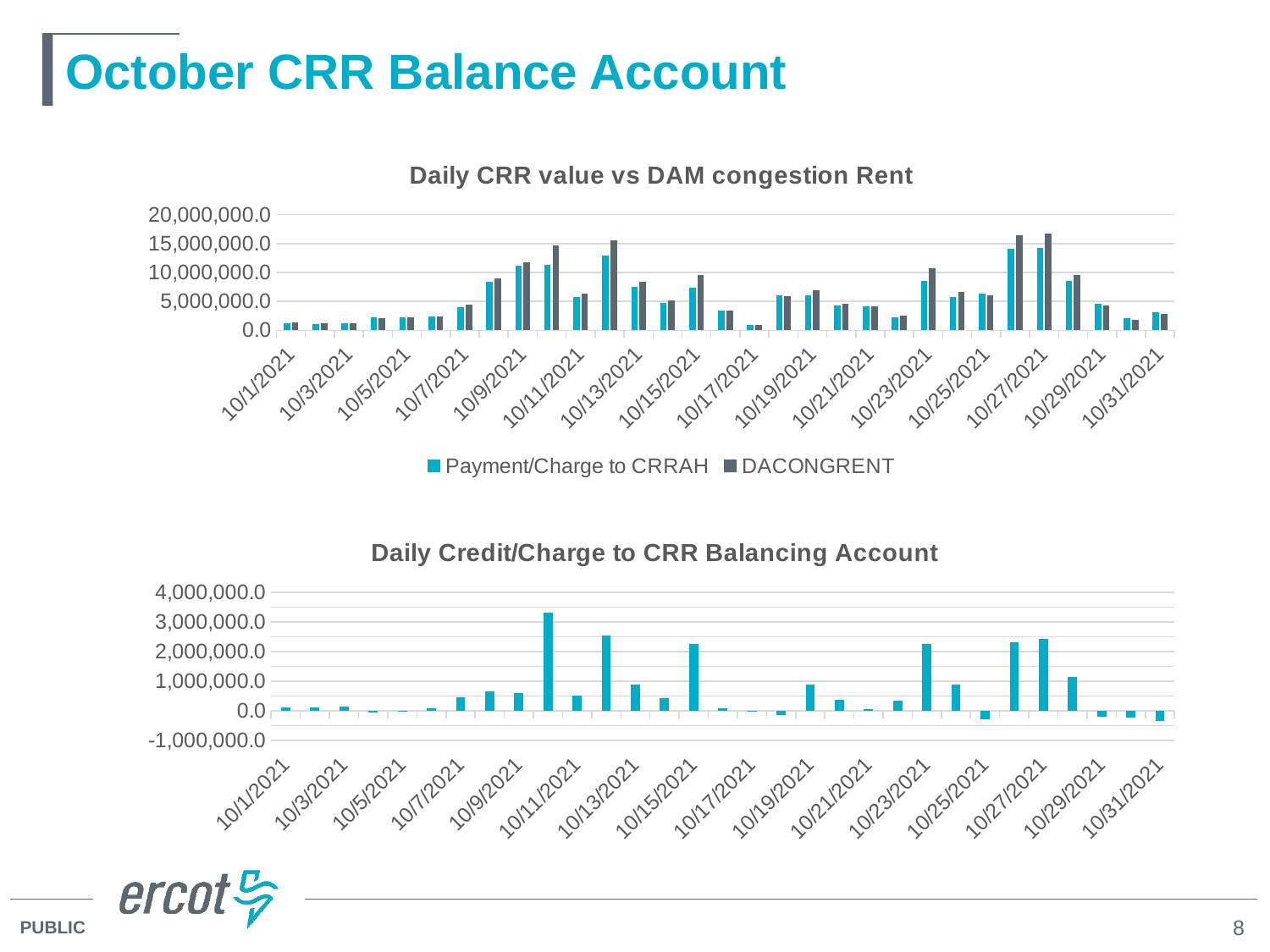
In the 'Daily CRR value vs DAM congestion Rent' chart, which is larger for Payment/Charge to CRRAH: 10/27/2021 or 10/17/2021? 10/27/2021 How many dates are labeled on the x axis of the 'Daily Credit/Charge to CRR Balancing Account' chart? 16 In the 'Daily Credit/Charge to CRR Balancing Account' chart, which is larger: the value for 10/27/2021 or the value for 10/29/2021? 10/27/2021 How many series does the legend of the 'Daily CRR value vs DAM congestion Rent' chart list? 2 In the 'Daily CRR value vs DAM congestion Rent' chart, what are the two series named in the legend? Payment/Charge to CRRAH and DACONGRENT In the 'Daily CRR value vs DAM congestion Rent' chart, is the Payment/Charge to CRRAH value for 10/27/2021 greater or less than 10,000,000.0? greater What kind of chart is the 'Daily Credit/Charge to CRR Balancing Account' chart? bar chart In the 'Daily CRR value vs DAM congestion Rent' chart, is the DACONGRENT value for 10/17/2021 greater or less than 5,000,000.0? less What kind of chart is the 'Daily CRR value vs DAM congestion Rent' chart? bar chart In the 'Daily Credit/Charge to CRR Balancing Account' chart, is the value for 10/27/2021 greater or less than 2,000,000.0? greater